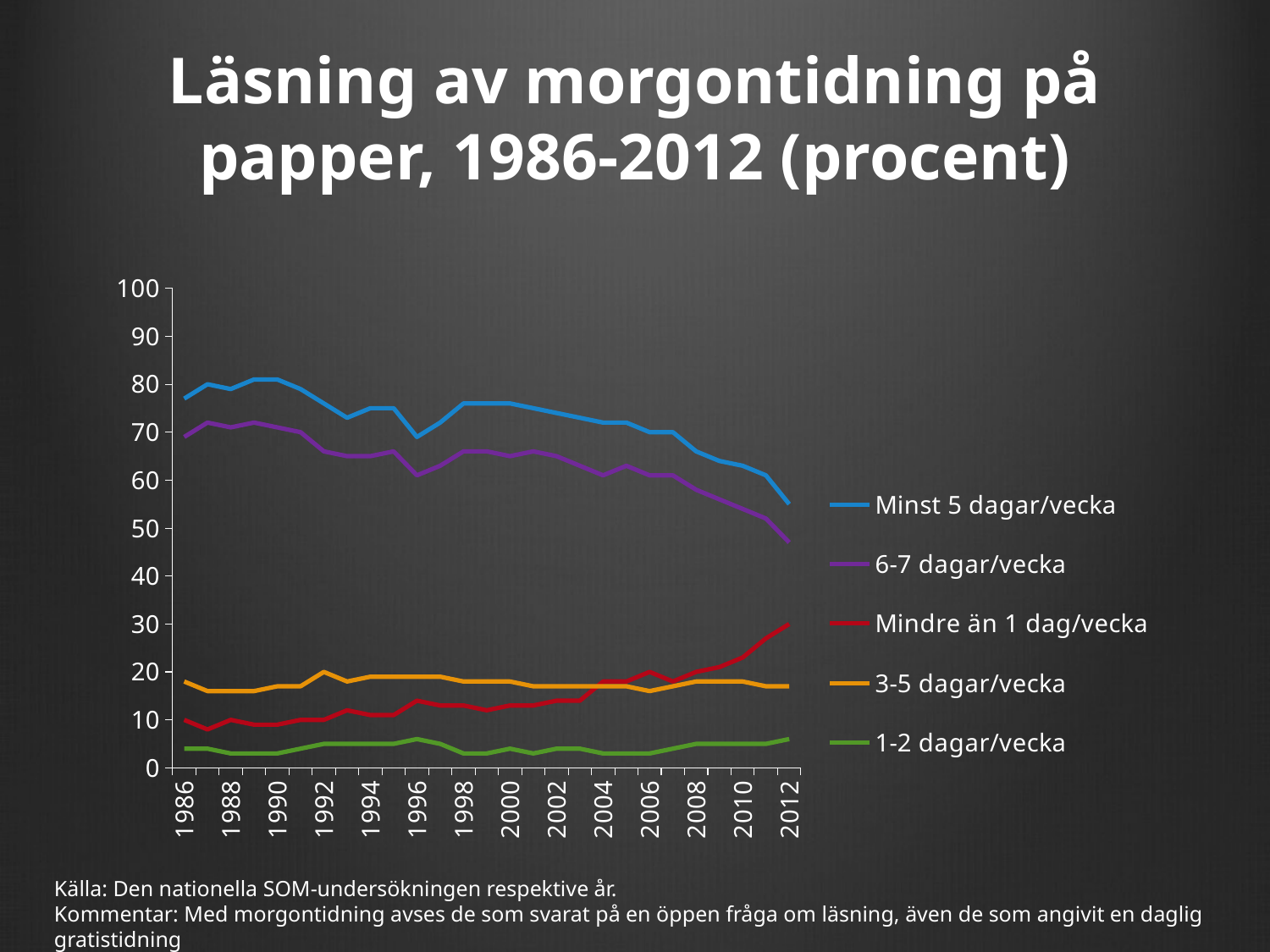
In 2012, which is larger: Mindre än 1 dag/vecka or 3-5 dagar/vecka? Mindre än 1 dag/vecka Does the Minst 5 dagar/vecka series rise or fall from 1986 to 2012? fall Is the value for 3-5 dagar/vecka in 1986 greater or less than 20? less Which series has the highest value in 2012? Minst 5 dagar/vecka Is the value for Minst 5 dagar/vecka in 1986 greater or less than 70? greater Is the value for Mindre än 1 dag/vecka in 2012 greater or less than 20? greater How many series does the legend list? 5 What kind of chart is shown on the slide? line chart Which series has the lowest value in 1986? 1-2 dagar/vecka Does the Mindre än 1 dag/vecka series rise or fall from 1986 to 2012? rise